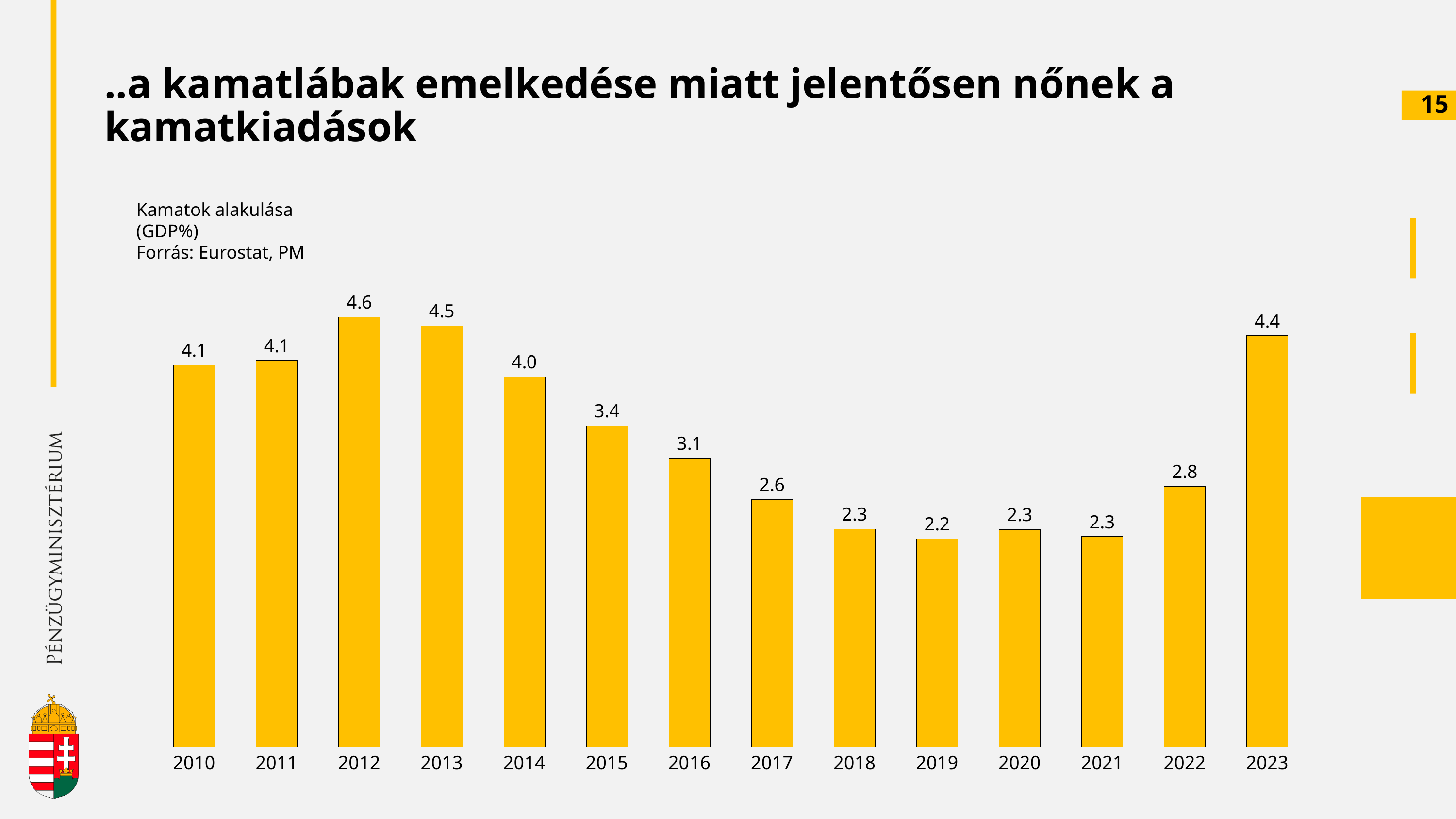
What is the value for 2023? 4.4 How many years are shown on the x axis? 14 What is the value for 2012? 4.6 Which year has the highest value? 2012 Do the values rise or fall from 2013 to 2019? fall What is the difference between the values for 2012 and 2019? 2.4 What is the value for 2019? 2.2 What is the difference between the values for 2023 and 2022? 1.6 What is the title of the chart? Kamatok alakulása (GDP%) Which is larger, the value for 2015 or the value for 2017? 2015 Which year has the lowest value? 2019 What kind of chart is shown on the slide? bar chart